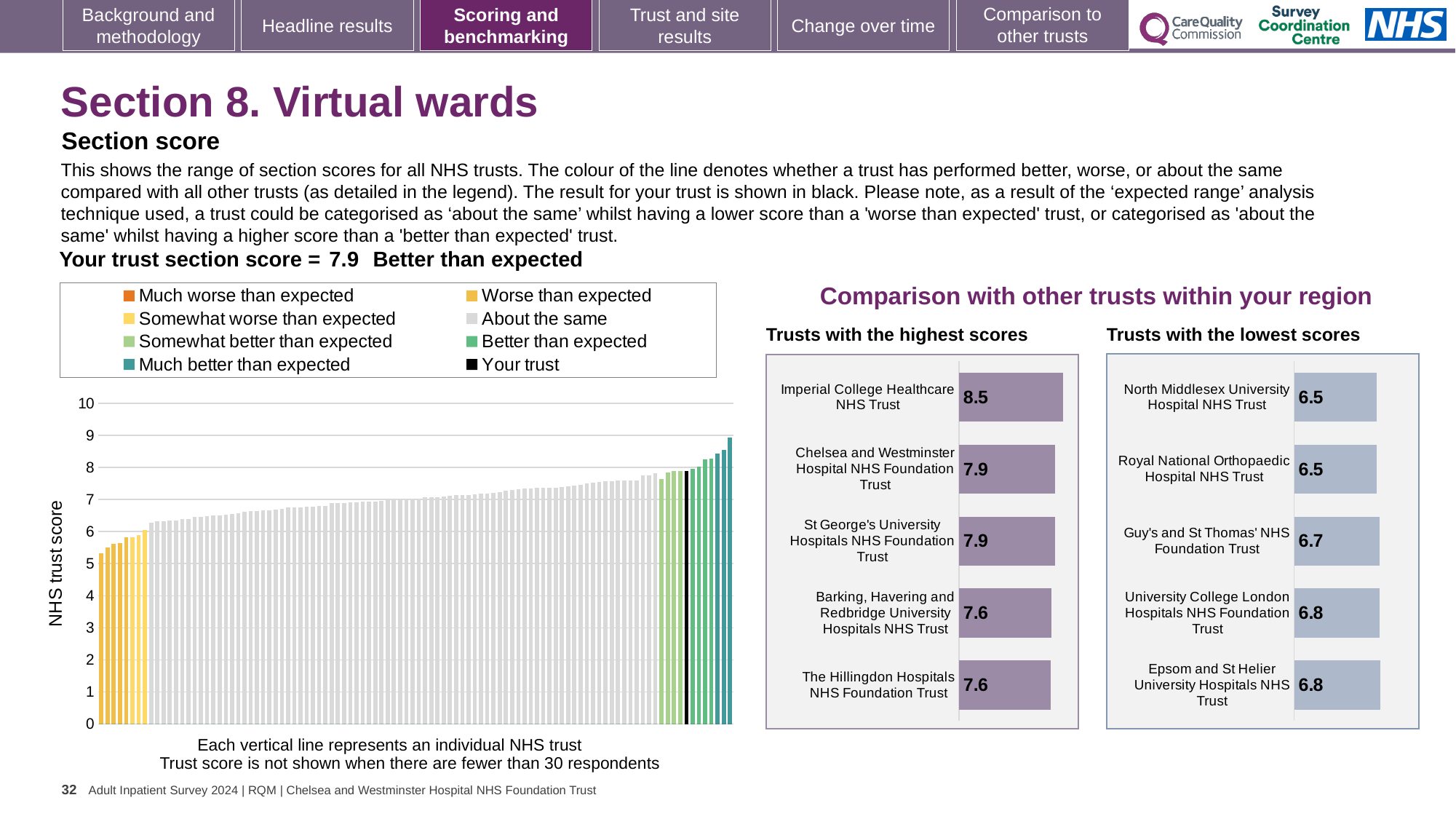
In the large chart on the left, is the value of the tallest bar greater or less than 8? greater In the 'Trusts with the highest scores' chart, which trust has the highest score? Imperial College Healthcare NHS Trust How many trusts are shown in the 'Trusts with the highest scores' chart? 5 In the large chart on the left, do the NHS trust scores rise or fall from left to right? Rise In the 'Trusts with the highest scores' chart, what is the score for The Hillingdon Hospitals NHS Foundation Trust? 7.6 In the large chart on the left, what colour is used for the bar representing your trust? Black In the 'Trusts with the highest scores' chart, what is the difference between the scores of Imperial College Healthcare NHS Trust and Barking, Havering and Redbridge University Hospitals NHS Trust? 0.9 In the 'Trusts with the lowest scores' chart, what is the score for Guy's and St Thomas' NHS Foundation Trust? 6.7 How many entries does the legend of the large chart on the left list? 8 In the 'Trusts with the highest scores' chart, what is the score for Imperial College Healthcare NHS Trust? 8.5 What kind of chart is the large chart on the left showing NHS trust scores? Bar chart In the 'Trusts with the lowest scores' chart, which has the larger score: University College London Hospitals NHS Foundation Trust or North Middlesex University Hospital NHS Trust? University College London Hospitals NHS Foundation Trust